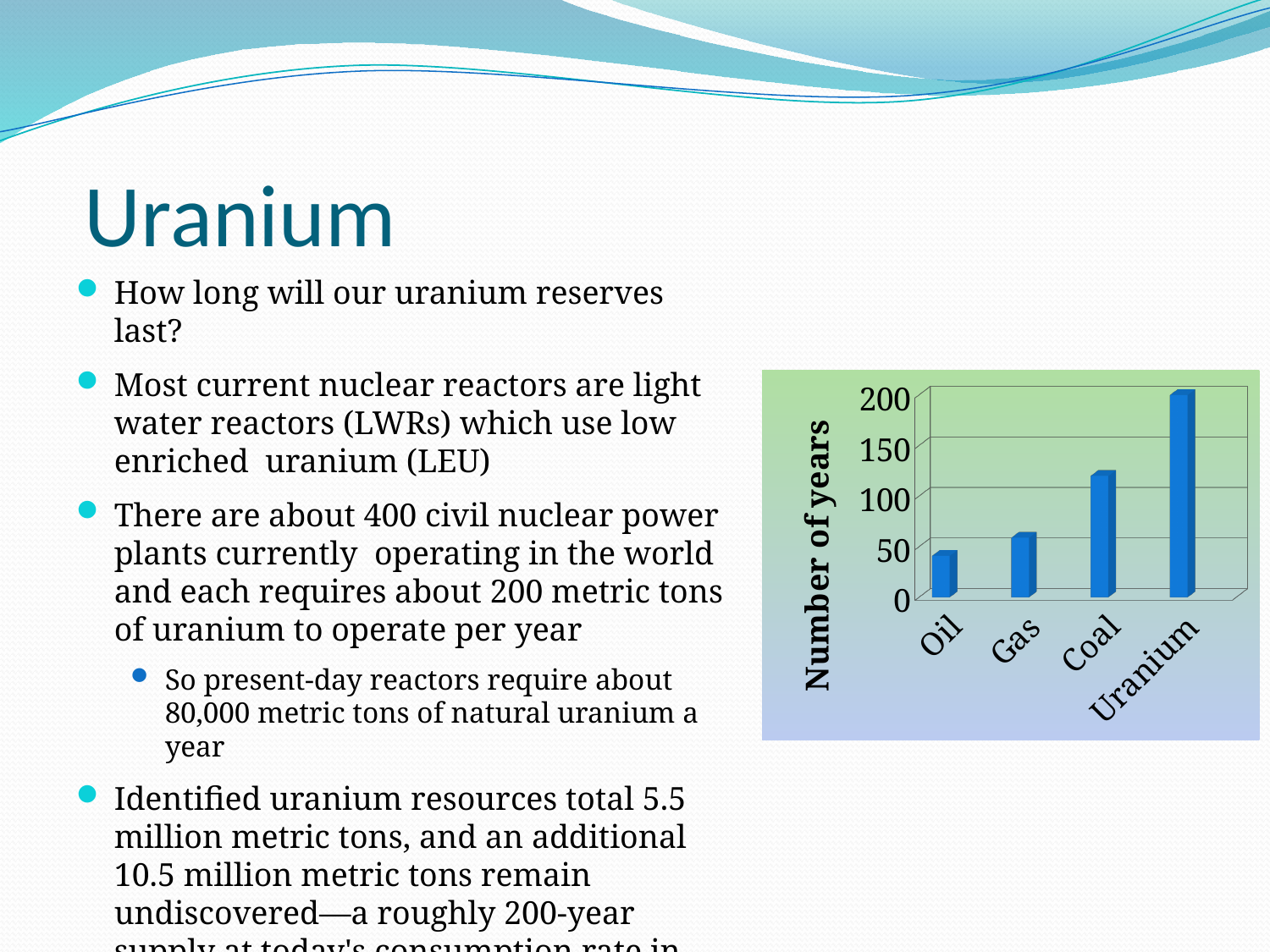
Is the value for Coal greater or less than 100? greater Is the value for Oil greater or less than 50? less What kind of chart is shown on the slide? bar chart What is the label on the vertical axis of the chart? Number of years Which has a larger value, Oil or Uranium? Uranium How many categories are plotted on the chart? 4 Is the value for Uranium greater or less than 150? greater Which category has the highest number of years? Uranium Do the values rise or fall moving from Oil to Uranium along the x axis? rise Which category has the lowest number of years? Oil Which has a larger value, Coal or Gas? Coal